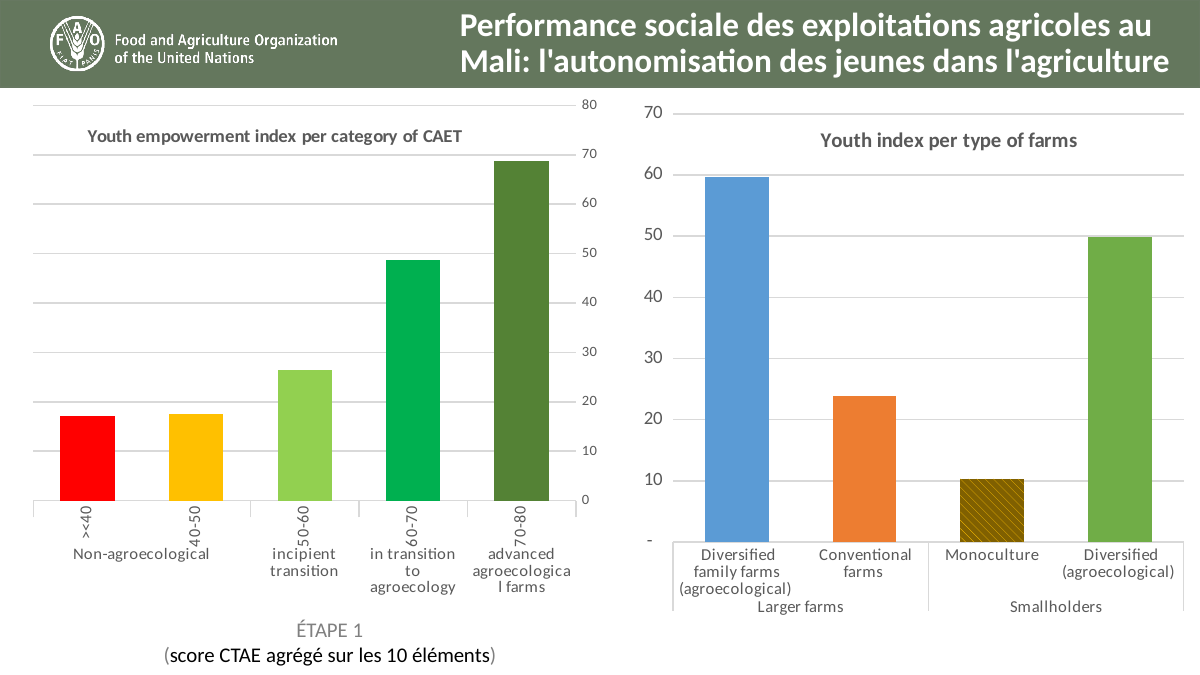
In the chart titled "Youth empowerment index per category of CAET", do the values rise or fall from left to right across the categories? rise In the chart titled "Youth index per type of farms", which two farm types are grouped under "Smallholders"? Monoculture and Diversified (agroecological) In the chart titled "Youth index per type of farms", how many types of farms are plotted? 4 In the chart titled "Youth empowerment index per category of CAET", what kind of chart is shown? bar chart In the chart titled "Youth empowerment index per category of CAET", how many categories are plotted? 5 In the chart titled "Youth index per type of farms", which type of farm has the lowest value? Monoculture In the chart titled "Youth empowerment index per category of CAET", is the value for 60-70 (in transition to agroecology) greater or less than 40? greater In the chart titled "Youth empowerment index per category of CAET", is the value for 50-60 (incipient transition) greater or less than 30? less In the chart titled "Youth empowerment index per category of CAET", which category has the highest value? 70-80 (advanced agroecological farms) In the chart titled "Youth index per type of farms", is the value for Conventional farms greater or less than 30? less In the chart titled "Youth index per type of farms", which type of farm has the highest value? Diversified family farms (agroecological) In the chart titled "Youth index per type of farms", which is larger: the value for Conventional farms or the value for Diversified (agroecological)? Diversified (agroecological)